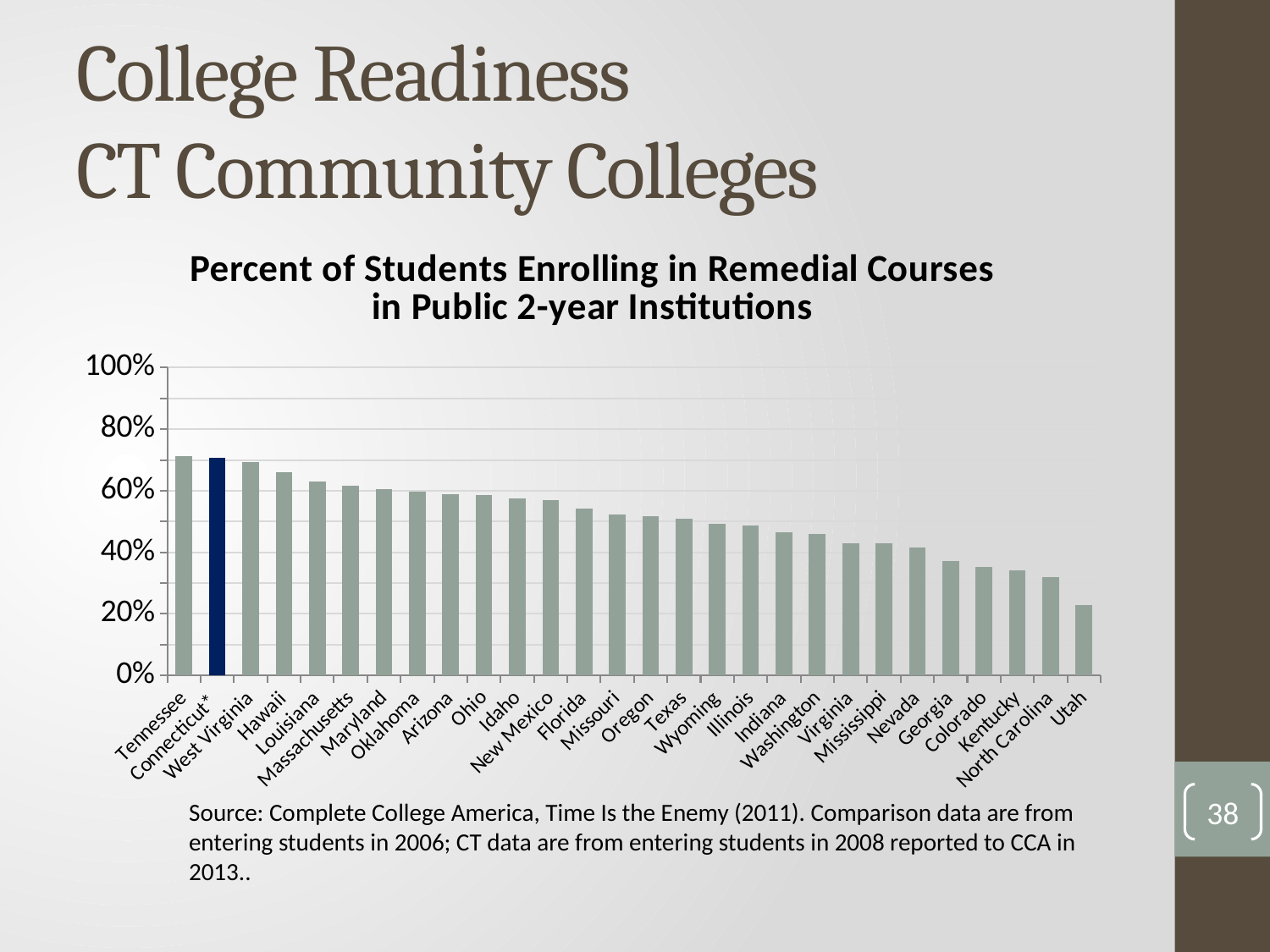
Which has a higher value, Hawaii or Nevada? Hawaii Is the value for Connecticut* greater or less than 60%? greater Is the value for Texas greater or less than 40%? greater How many states are shown on the x axis of the chart? 28 What kind of chart is shown on the slide? bar chart Is the value for Utah greater or less than 40%? less What is the title of the chart? Percent of Students Enrolling in Remedial Courses in Public 2-year Institutions Which state has the lowest percent of students enrolling in remedial courses? Utah Which state's bar is shown in a different colour (dark blue) from the others? Connecticut* Do the values rise or fall moving from left to right along the x axis? fall